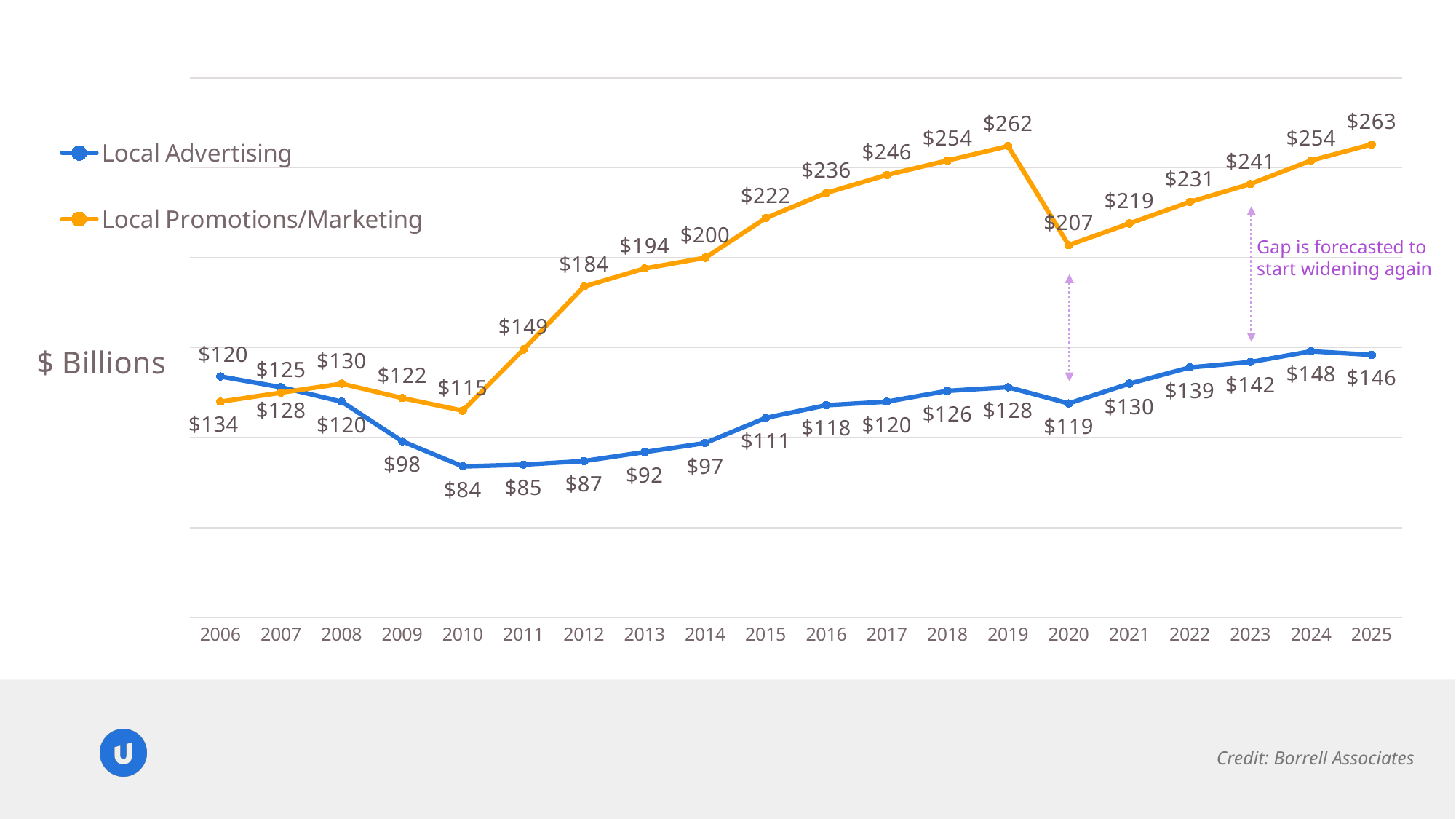
What is the Local Promotions/Marketing value for 2019? $262 How many years are shown on the x axis? 20 What is the Local Promotions/Marketing value for 2020? $207 In which year is Local Promotions/Marketing highest? 2025 What is the Local Advertising value for 2025? $146 What kind of chart is shown on the slide? Line chart In which year is Local Advertising lowest? 2010 Which series has the higher value in 2006, Local Advertising or Local Promotions/Marketing? Local Advertising How many series does the legend list? 2 Does Local Promotions/Marketing rise or fall from 2020 to 2025? Rise What is the difference between Local Promotions/Marketing and Local Advertising in 2025? $117 What is the Local Advertising value for 2010? $84